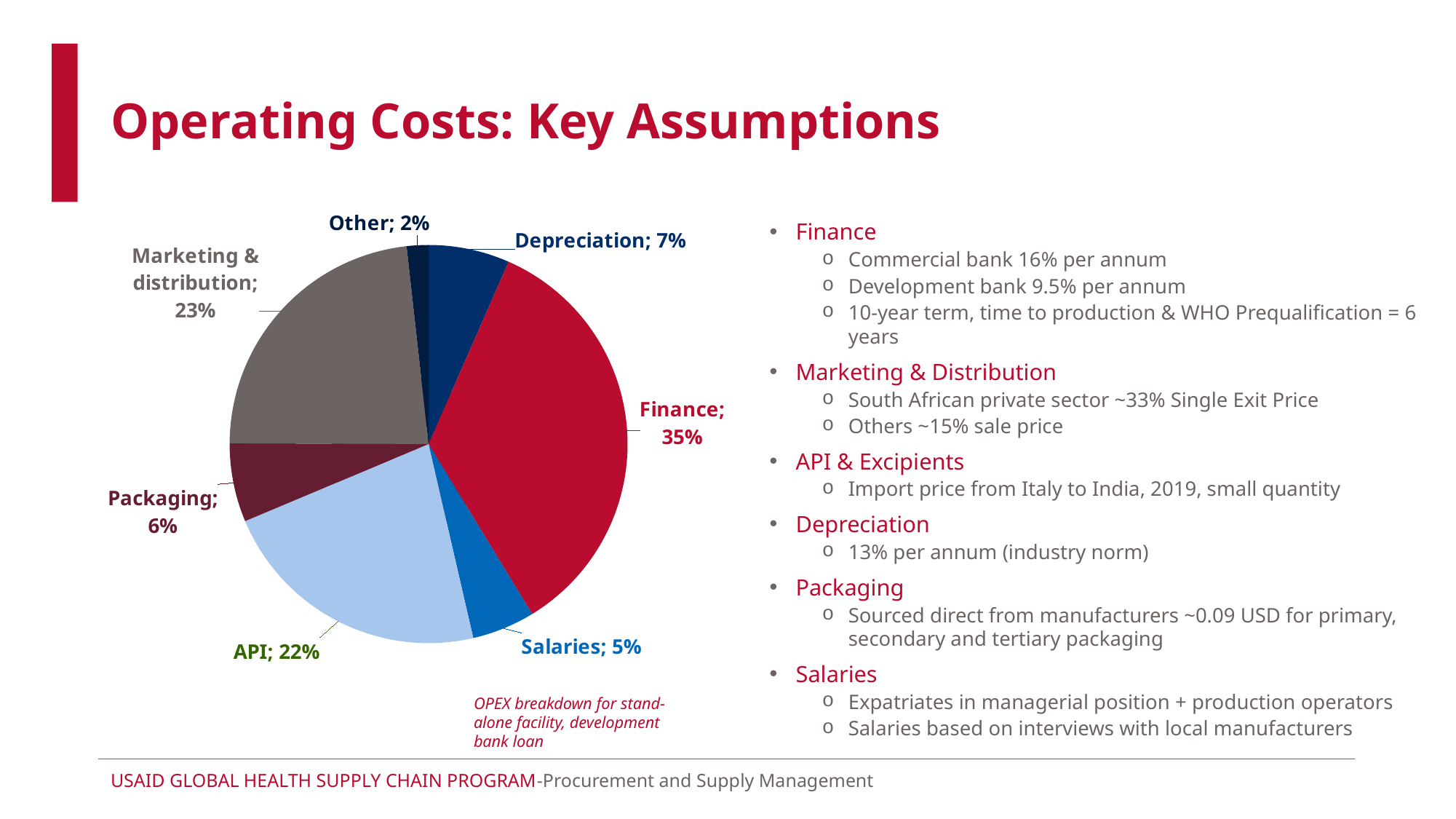
What does the italic caption below the pie chart say the chart shows? OPEX breakdown for stand-alone facility, development bank loan What is the value shown for Marketing & distribution? 23% What is the difference between the Finance share and the Marketing & distribution share? 12% How many categories are shown in the pie chart? 7 What kind of chart is shown on the slide? Pie chart What is the value shown for Depreciation? 7% Which category has the largest slice of the pie? Finance Which category has the smallest slice of the pie? Other What is the value shown for API? 22% What share of the pie does Finance account for? 35% Which is larger, the Packaging slice or the Salaries slice? Packaging What is the combined share of Salaries and Other? 7%